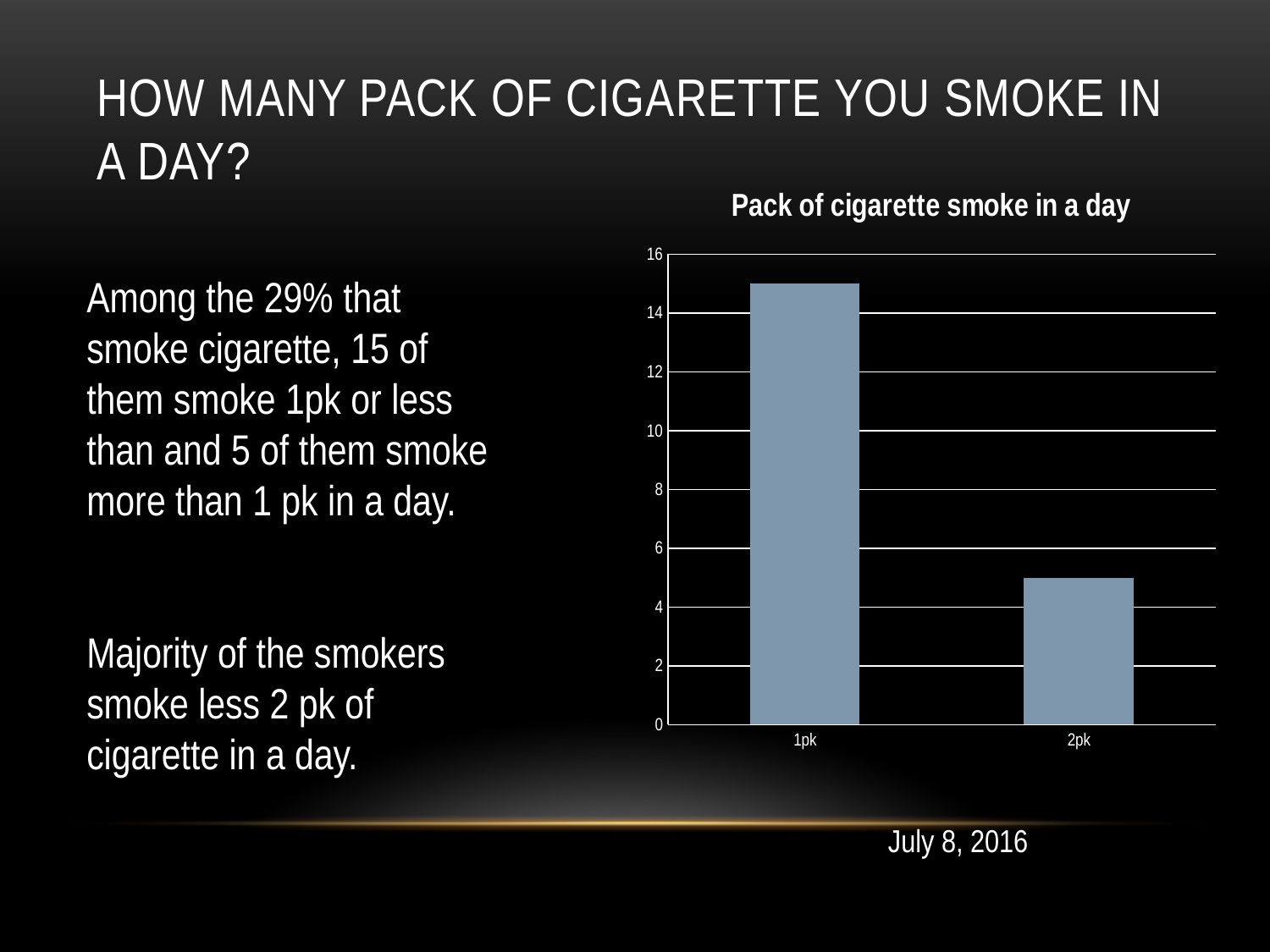
What type of chart is shown on the slide? bar chart Is the value for 2pk greater or less than 4? greater What is the title of the chart? Pack of cigarette smoke in a day How many smokers does the chart show for 1pk? 15 Do the values rise or fall from 1pk to 2pk along the x axis? fall Which category has the highest bar in the chart? 1pk Which is larger, the value for 1pk or the value for 2pk? 1pk Is the value for 2pk greater or less than 6? less Which category has the lowest bar in the chart? 2pk Is the value for 1pk greater or less than 14? greater How many categories are shown on the x axis of the chart? 2 How many smokers does the chart show for 2pk? 5